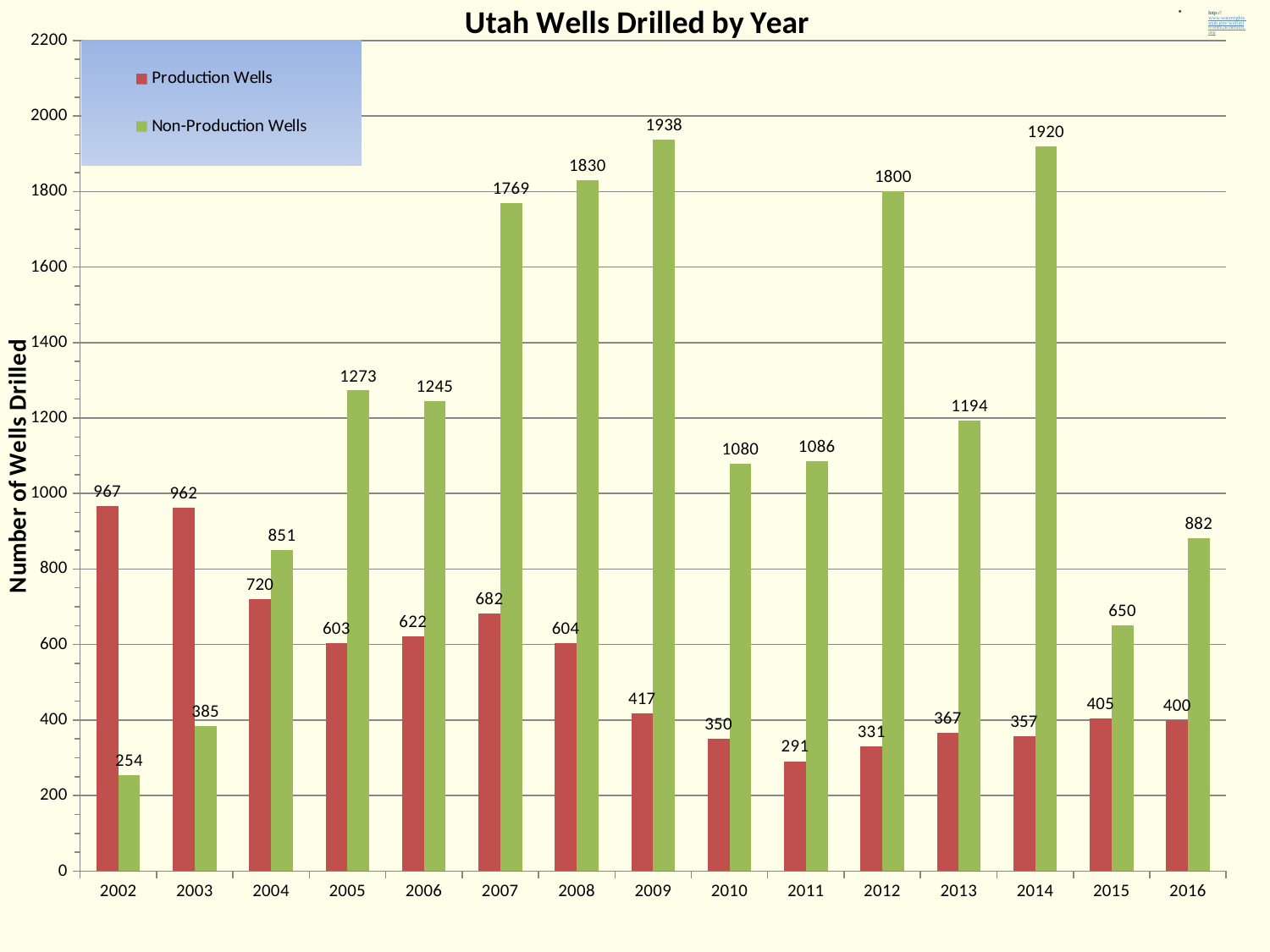
Which year has the highest number of Non-Production Wells? 2009 How many years are shown on the x axis? 15 Do the Production Wells values generally rise or fall from 2002 to 2011? Fall What kind of chart is shown on the slide? Bar chart Which year has the lowest number of Production Wells? 2011 Which is larger in 2003: Production Wells or Non-Production Wells? Production Wells How many series does the legend list? 2 What is the number of Production Wells drilled in 2002? 967 What is the title of the chart? Utah Wells Drilled by Year Is the value for Non-Production Wells in 2012 greater or less than 1600? greater What is the number of Non-Production Wells drilled in 2014? 1920 What is the difference between Non-Production Wells and Production Wells in 2008? 1226